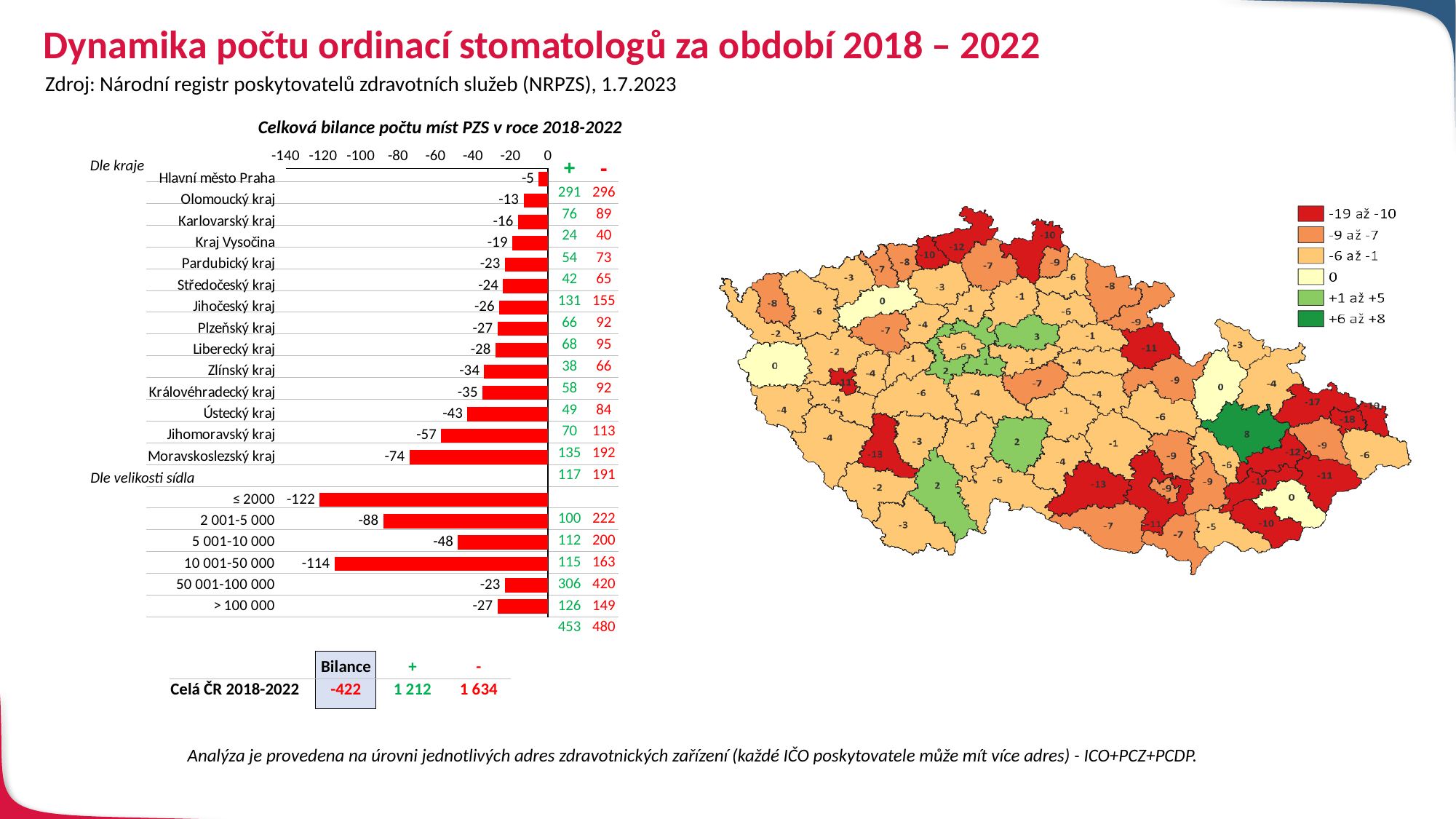
In the bar chart 'Celková bilance počtu míst PZS v roce 2018-2022', how many regions (kraje) are listed under 'Dle kraje'? 14 In the bar chart 'Celková bilance počtu míst PZS v roce 2018-2022', what is the value for the settlement size category ≤ 2000? -122 What is the title of the bar chart on the left side of the slide? Celková bilance počtu míst PZS v roce 2018-2022 In the bar chart 'Celková bilance počtu míst PZS v roce 2018-2022', which region (kraj) has the highest (least negative) value? Hlavní město Praha In the bar chart 'Celková bilance počtu míst PZS v roce 2018-2022', what is the difference between the values for Jihomoravský kraj and Ústecký kraj? 14 In the bar chart 'Celková bilance počtu míst PZS v roce 2018-2022', which settlement size category has the lowest (most negative) value? ≤ 2000 In the bar chart 'Celková bilance počtu míst PZS v roce 2018-2022', what is the value for Hlavní město Praha? -5 In the bar chart 'Celková bilance počtu míst PZS v roce 2018-2022', what is the value for the settlement size category 10 001-50 000? -114 In the bar chart 'Celková bilance počtu míst PZS v roce 2018-2022', which has the more negative value: Zlínský kraj or Královéhradecký kraj? Královéhradecký kraj In the bar chart 'Celková bilance počtu míst PZS v roce 2018-2022', what is the value for Moravskoslezský kraj? -74 In the bar chart 'Celková bilance počtu míst PZS v roce 2018-2022', which region (kraj) has the lowest (most negative) value? Moravskoslezský kraj What type of chart is 'Celková bilance počtu míst PZS v roce 2018-2022'? Bar chart